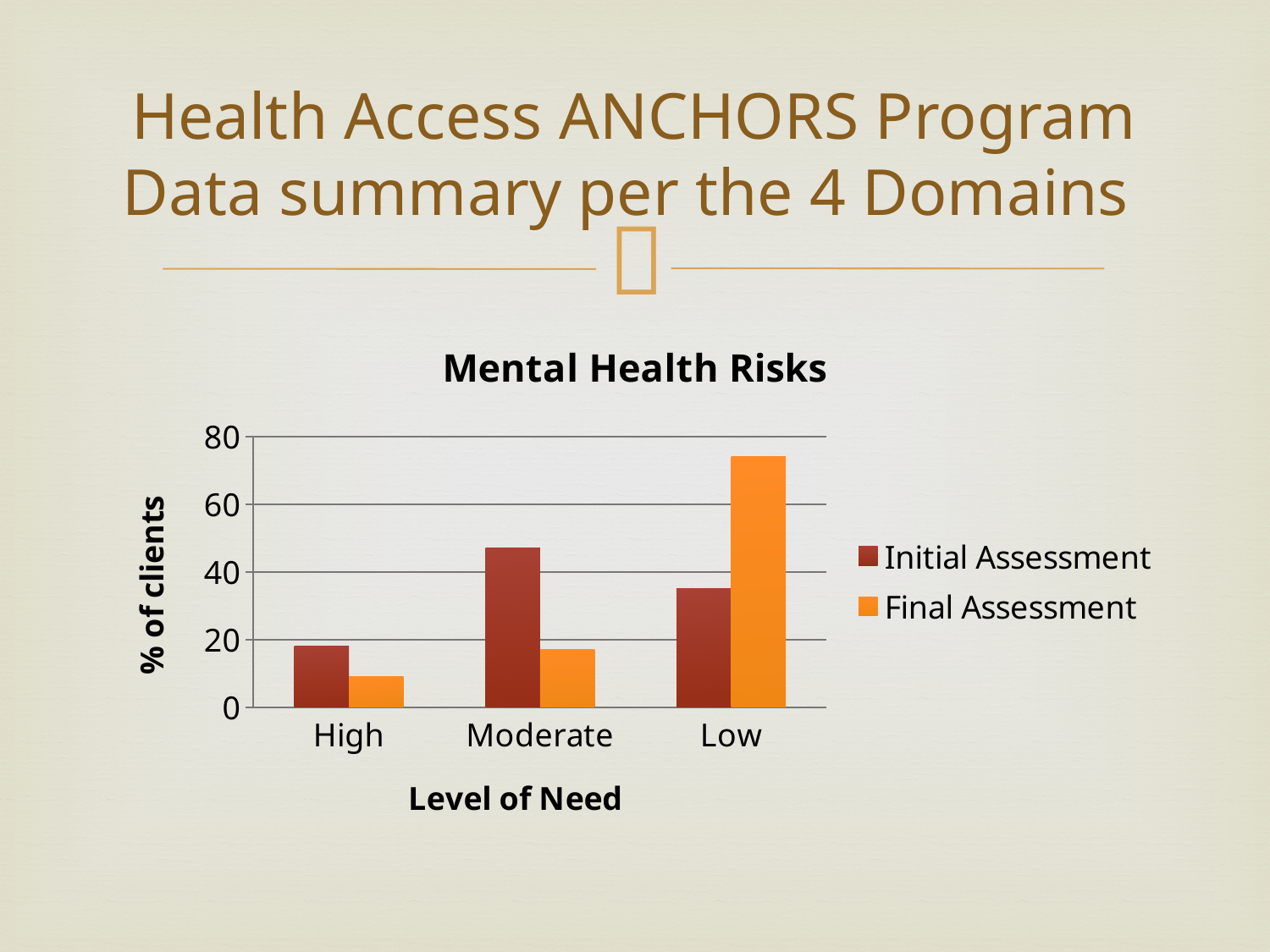
What kind of chart is shown on the slide? bar chart What is the label of the y axis? % of clients How many series does the legend list? 2 Is the Initial Assessment value for Moderate greater or less than 40? greater For the Low category, which is larger: Initial Assessment or Final Assessment? Final Assessment Which category has the lowest Final Assessment value? High Which category has the highest Initial Assessment value? Moderate Is the Final Assessment value for Low greater or less than 60? greater How many categories are shown on the x axis? 3 Which category has the lowest Initial Assessment value? High Which category has the highest Final Assessment value? Low What is the title of the chart? Mental Health Risks